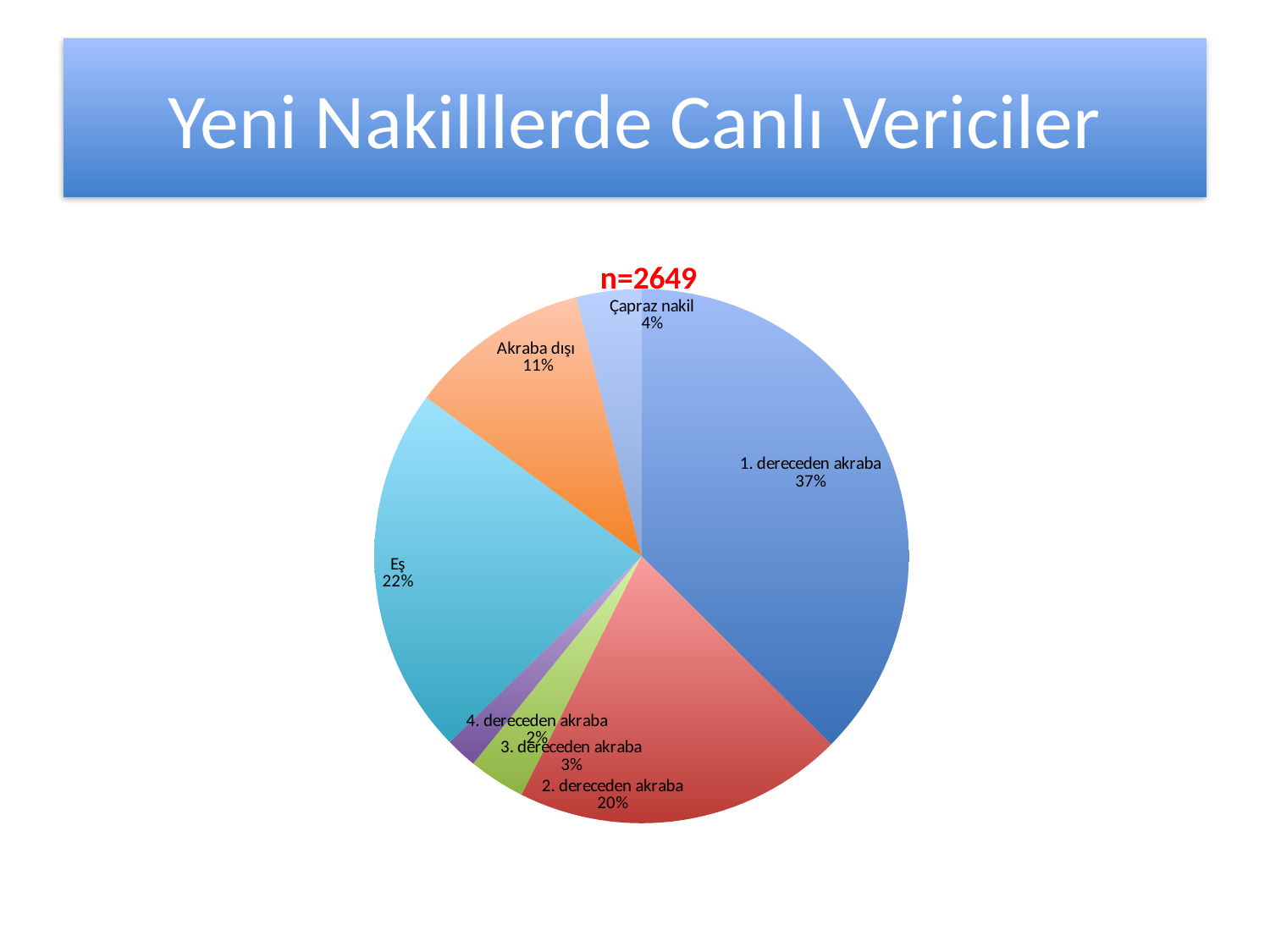
What share of the pie does "Çapraz nakil" represent? 4% What is the difference in percentage points between "1. dereceden akraba" and "Eş"? 15 What sample size (n) is shown above the pie chart? n=2649 What share of the pie does "Akraba dışı" represent? 11% What share of the pie does "2. dereceden akraba" represent? 20% Which category has the largest slice of the pie? 1. dereceden akraba What kind of chart is shown on the slide? pie chart Which category has the smallest slice of the pie? 4. dereceden akraba How many slices does the pie chart have? 7 Which is larger, the slice for "Eş" or the slice for "2. dereceden akraba"? Eş